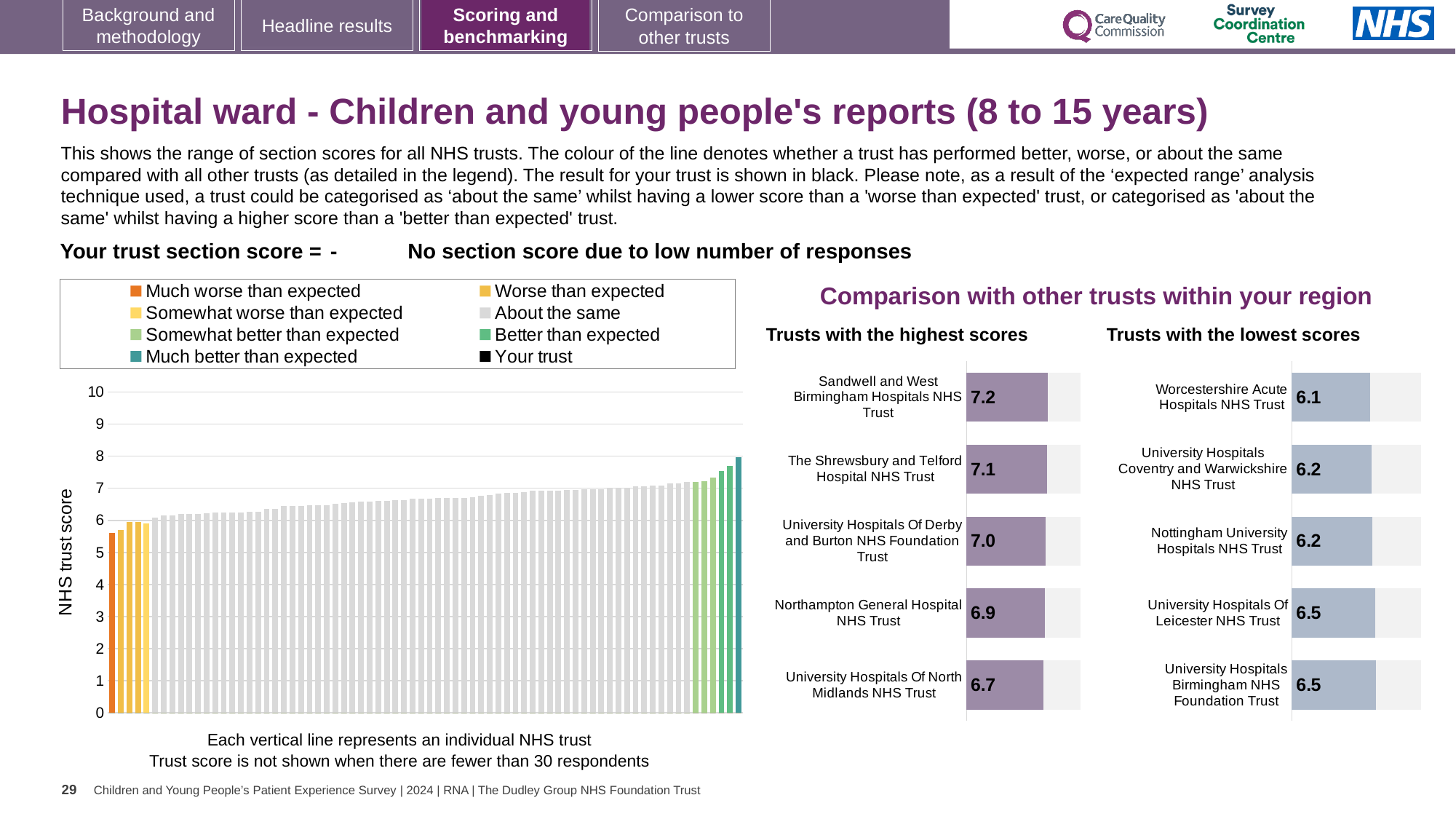
In the 'Trusts with the highest scores' chart, what is the difference between the scores of Sandwell and West Birmingham Hospitals NHS Trust and University Hospitals Of North Midlands NHS Trust? 0.5 In the main 'NHS trust score' chart, is the value of the tallest (rightmost) bar greater or less than 7? greater In the 'Trusts with the highest scores' chart, which trust has the highest score? Sandwell and West Birmingham Hospitals NHS Trust How many entries does the legend above the main 'NHS trust score' bar chart list? 8 In the 'Trusts with the lowest scores' chart, what is the score for Nottingham University Hospitals NHS Trust? 6.2 In the 'Trusts with the lowest scores' chart, what is the score for Worcestershire Acute Hospitals NHS Trust? 6.1 How many trusts are listed in the 'Trusts with the highest scores' chart? 5 In the 'Trusts with the lowest scores' chart, which trust has the lowest score? Worcestershire Acute Hospitals NHS Trust Which has the higher score: Northampton General Hospital NHS Trust in the highest scores chart or University Hospitals Of Leicester NHS Trust in the lowest scores chart? Northampton General Hospital NHS Trust In the 'Trusts with the highest scores' chart, what is the score for Sandwell and West Birmingham Hospitals NHS Trust? 7.2 In the main 'NHS trust score' chart, do the bar values rise or fall from left to right? Rise What kind of chart is the main chart with the 'NHS trust score' axis? Bar chart